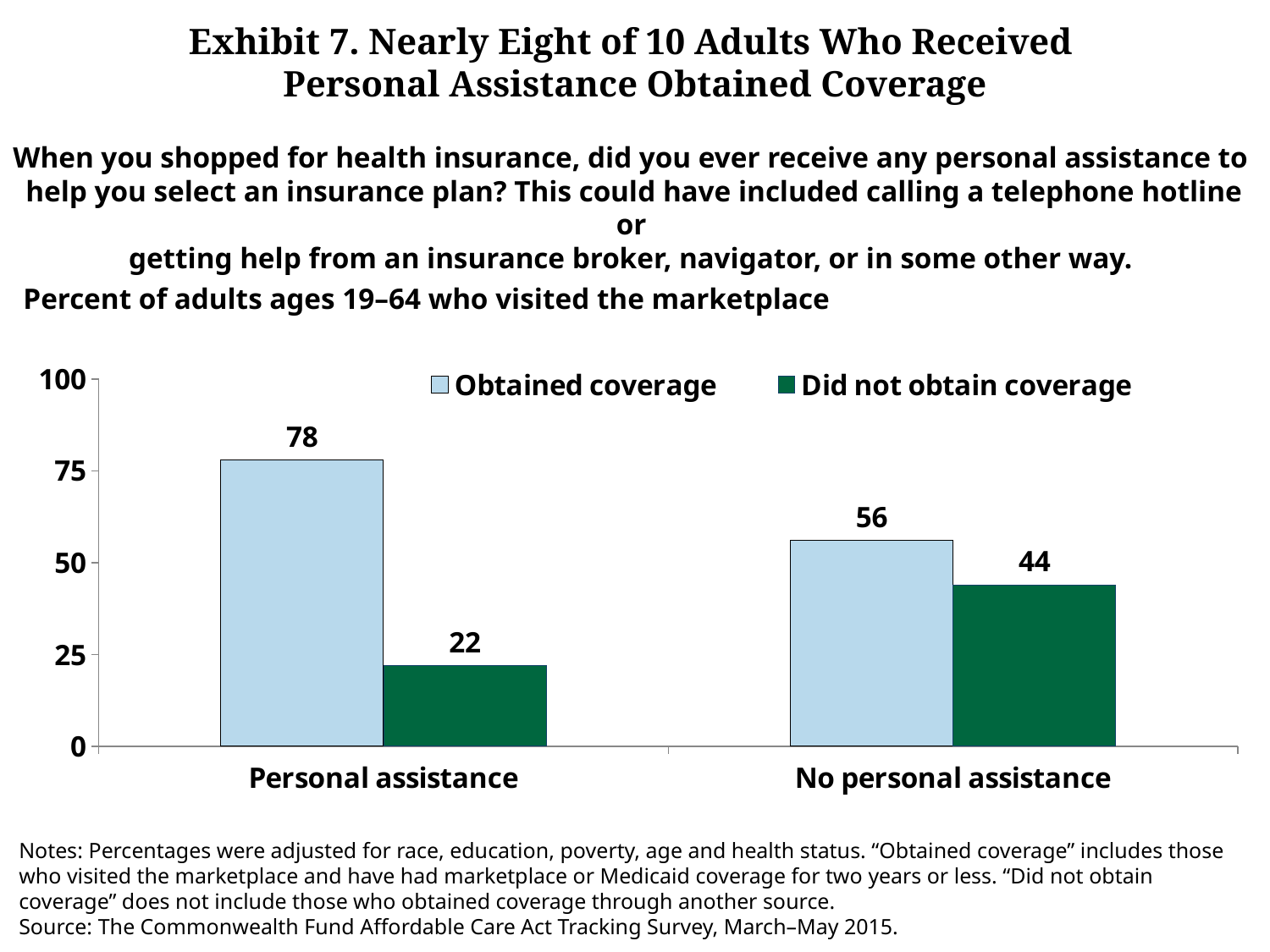
What is the value for 'Obtained coverage' in the 'No personal assistance' group? 56 What is the value for 'Did not obtain coverage' in the 'Personal assistance' group? 22 What is the difference between 'Obtained coverage' and 'Did not obtain coverage' for the 'Personal assistance' group? 56 Is the 'Did not obtain coverage' value larger for 'Personal assistance' or 'No personal assistance'? No personal assistance Which bar on the chart has the lowest value? Did not obtain coverage, Personal assistance How much higher is 'Obtained coverage' for 'Personal assistance' than for 'No personal assistance'? 22 What percentage of adults who received no personal assistance did not obtain coverage? 44 Which group has the higher value for 'Obtained coverage'? Personal assistance How many series does the legend list? 2 How many categories are shown on the x axis? 2 What percentage of adults who received personal assistance obtained coverage? 78 What kind of chart is shown on the slide? Bar chart